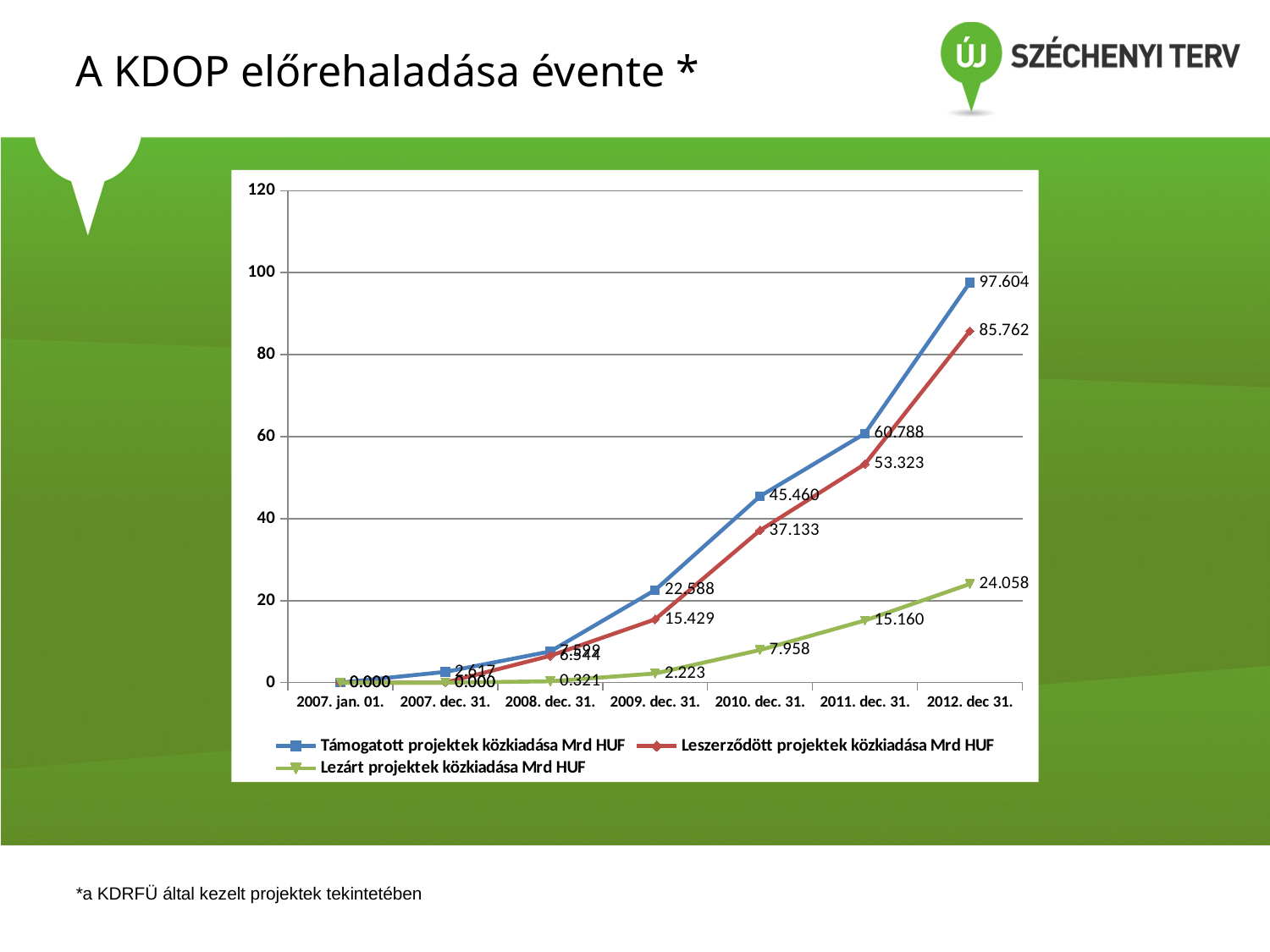
How many dates are plotted along the x axis? 7 How many series does the legend list? 3 What is the value of Leszerződött projektek közkiadása Mrd HUF at 2011. dec. 31.? 53.323 At which date is Lezárt projektek közkiadása Mrd HUF highest? 2012. dec 31. Does Támogatott projektek közkiadása Mrd HUF rise or fall from 2007. jan. 01. to 2012. dec 31.? rise What is the value of Lezárt projektek közkiadása Mrd HUF at 2010. dec. 31.? 7.958 What is the value of Leszerződött projektek közkiadása Mrd HUF at 2009. dec. 31.? 15.429 What kind of chart is shown on the slide? line chart At 2010. dec. 31., which is larger: Támogatott projektek közkiadása or Leszerződött projektek közkiadása? Támogatott projektek közkiadása Mrd HUF What is the difference between Támogatott projektek közkiadása and Leszerződött projektek közkiadása at 2012. dec 31.? 11.842 What is the title of the slide containing the chart? A KDOP előrehaladása évente * What is the value of Támogatott projektek közkiadása Mrd HUF at 2012. dec 31.? 97.604